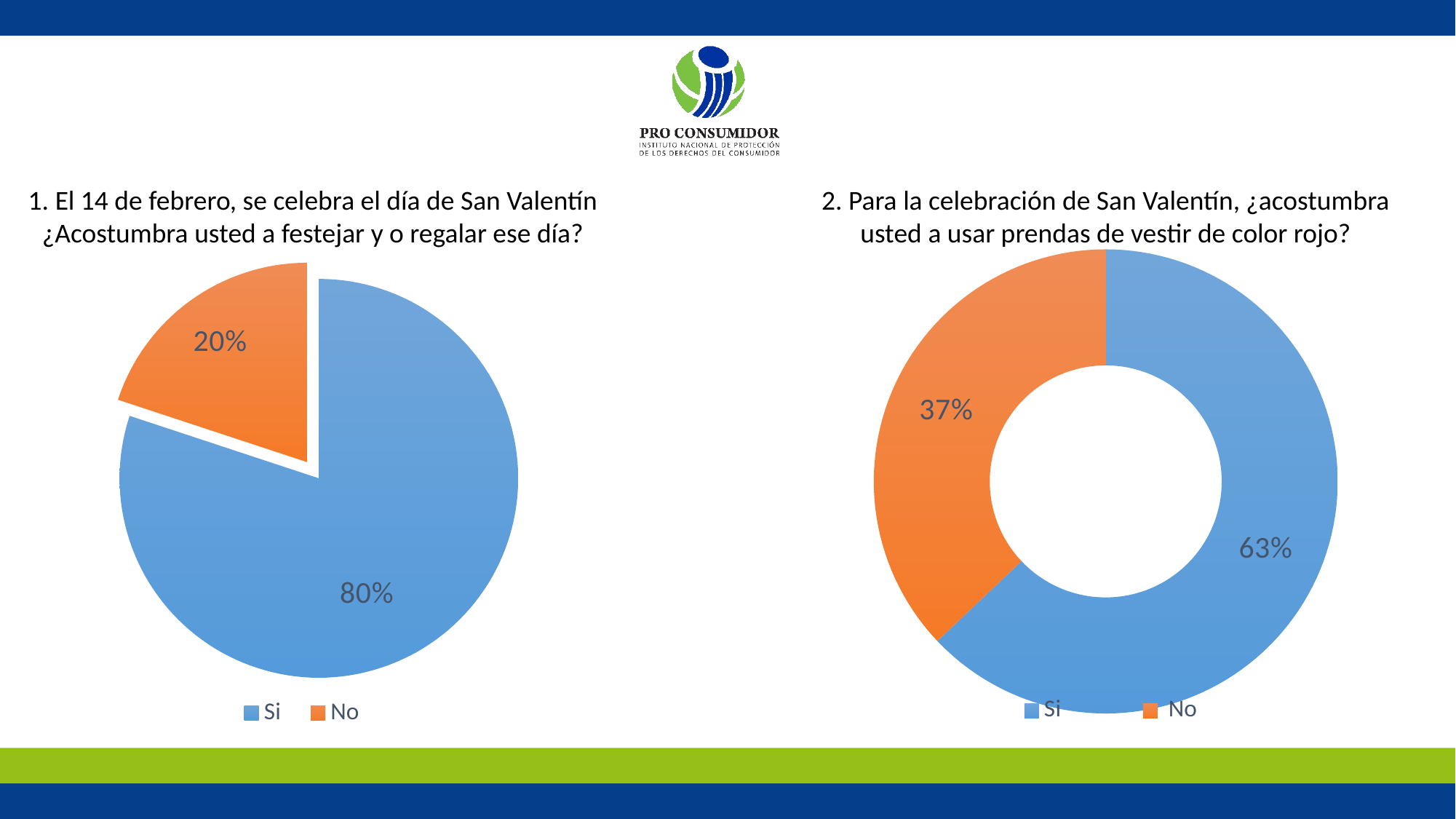
In the left chart (question 1, about celebrating or giving gifts on San Valentín), what percentage answered Si? 80% In the left chart (question 1), which response has the largest share? Si How many categories does the legend of the right chart (question 2) list? 2 In the right chart (question 2), what percentage answered No? 37% Is the Si share larger in the left chart (question 1) or in the right chart (question 2)? Left chart (question 1) In the left chart (question 1), what colour represents the No response? Orange In the left chart (question 1), what is the difference in percentage points between Si and No? 60 In the right chart (question 2, about wearing red clothing), what percentage answered Si? 63% In the left chart (question 1), what percentage answered No? 20% What type of chart is the left chart (question 1)? Pie chart In the right chart (question 2), which response has the smallest share? No In the right chart (question 2), what is the difference in percentage points between Si and No? 26